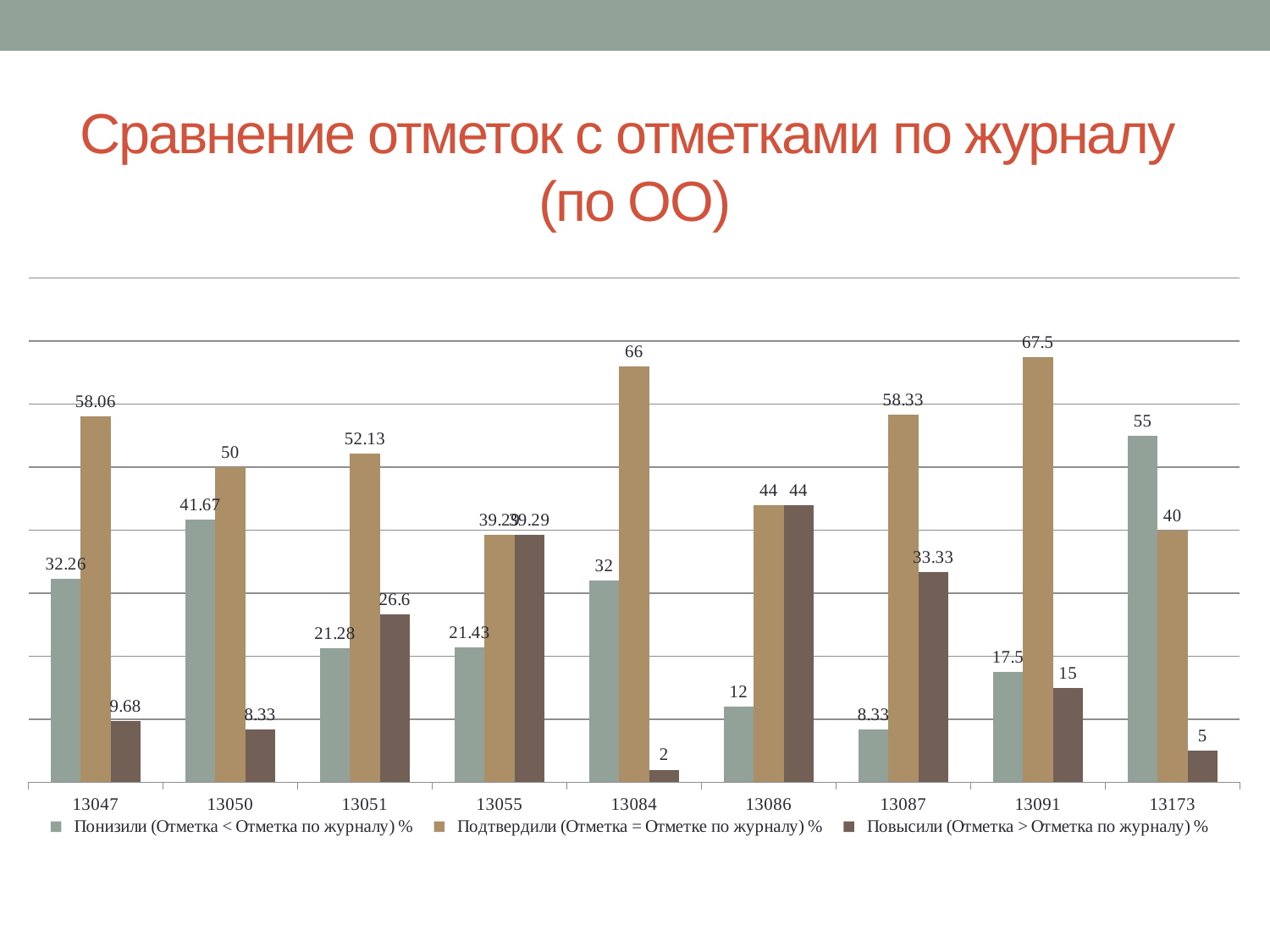
What is the title of the chart on the slide? Сравнение отметок с отметками по журналу (по ОО) What is the difference between the Подтвердили and Понизили values for 13173? 15 What type of chart is shown on the slide? bar chart Which category has the highest value for Понизили (Отметка < Отметка по журналу) %? 13173 What is the value of Подтвердили (Отметка = Отметке по журналу) % for 13084? 66 How many categories (ОО codes) are shown on the x axis? 9 How many series does the legend list? 3 What is the value of Понизили (Отметка < Отметка по журналу) % for 13050? 41.67 Which category has the highest value for Подтвердили (Отметка = Отметке по журналу) %? 13091 For 13051, which is larger: Понизили (Отметка < Отметка по журналу) % or Повысили (Отметка > Отметка по журналу) %? Повысили (Отметка > Отметка по журналу) % Which category has the lowest value for Повысили (Отметка > Отметка по журналу) %? 13084 What is the value of Повысили (Отметка > Отметка по журналу) % for 13087? 33.33